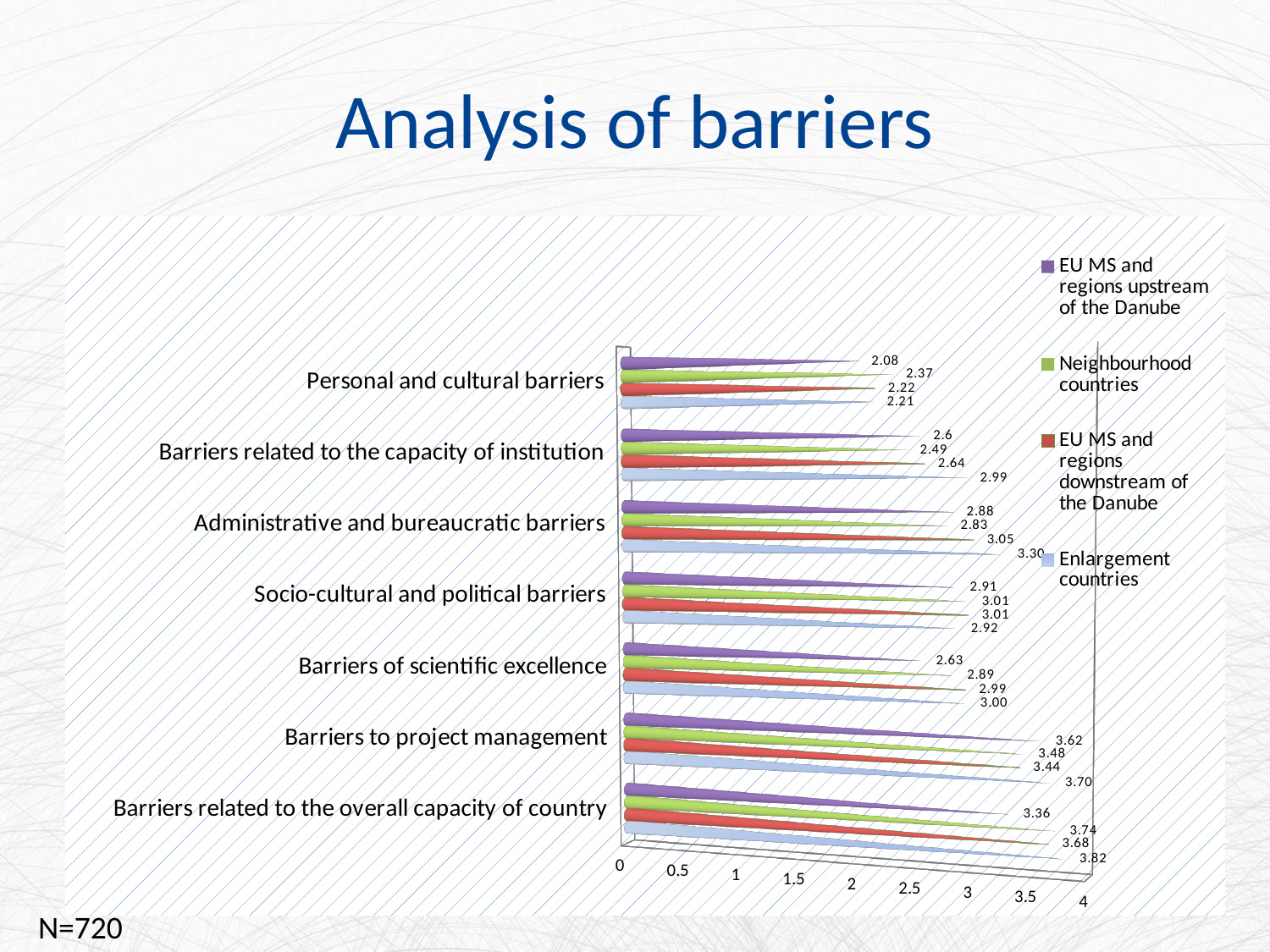
What is the difference between the Enlargement countries value and the EU MS and regions upstream of the Danube value for Barriers related to the overall capacity of country? 0.46 How many barrier categories are plotted on the chart? 7 What is the value for EU MS and regions upstream of the Danube for Personal and cultural barriers? 2.08 What is the title of the slide containing the chart? Analysis of barriers What is the value for Enlargement countries for Barriers related to the overall capacity of country? 3.82 What is the value for Neighbourhood countries for Barriers to project management? 3.48 How many series does the legend list? 4 For Barriers of scientific excellence, which is larger: the value for Neighbourhood countries or the value for EU MS and regions upstream of the Danube? Neighbourhood countries What is the value for EU MS and regions downstream of the Danube for Administrative and bureaucratic barriers? 3.05 Which category has the lowest value for EU MS and regions upstream of the Danube? Personal and cultural barriers Which category has the highest value for Enlargement countries? Barriers related to the overall capacity of country What kind of chart is shown on the slide? bar chart